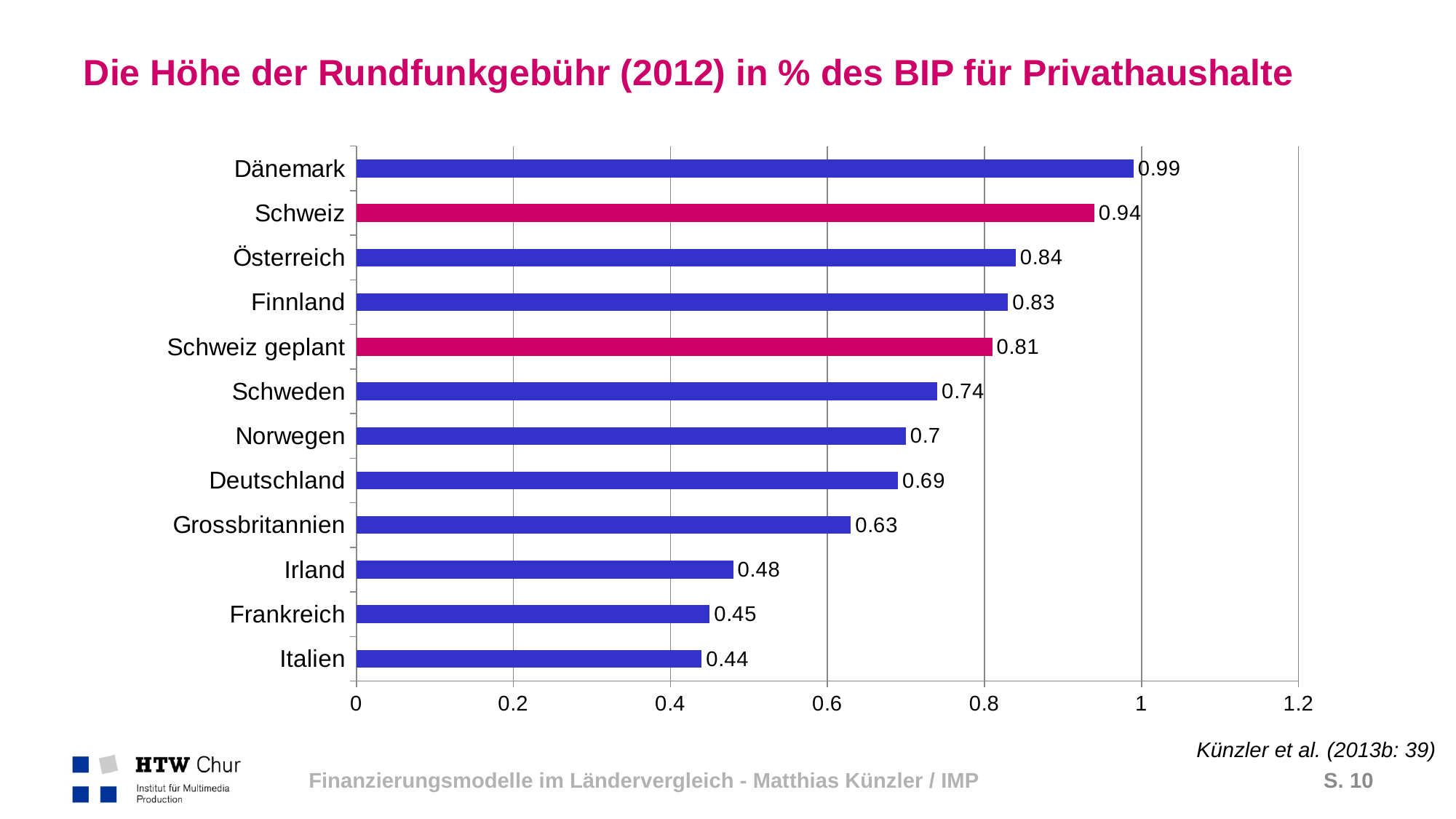
What is the value for Dänemark? 0.99 Which has a larger value, Schweden or Norwegen? Schweden Is the value for Irland greater or less than 0.6? less What kind of chart is shown on the slide? Bar chart What is the difference between the values for Dänemark and Italien? 0.55 What is the value for Grossbritannien? 0.63 What is the difference between the values for Schweiz and Schweiz geplant? 0.13 Which two bars are coloured magenta instead of blue? Schweiz and Schweiz geplant Which country has the lowest value? Italien Which country has the highest value? Dänemark What is the value for Schweiz geplant? 0.81 How many countries/categories are shown in the chart? 12